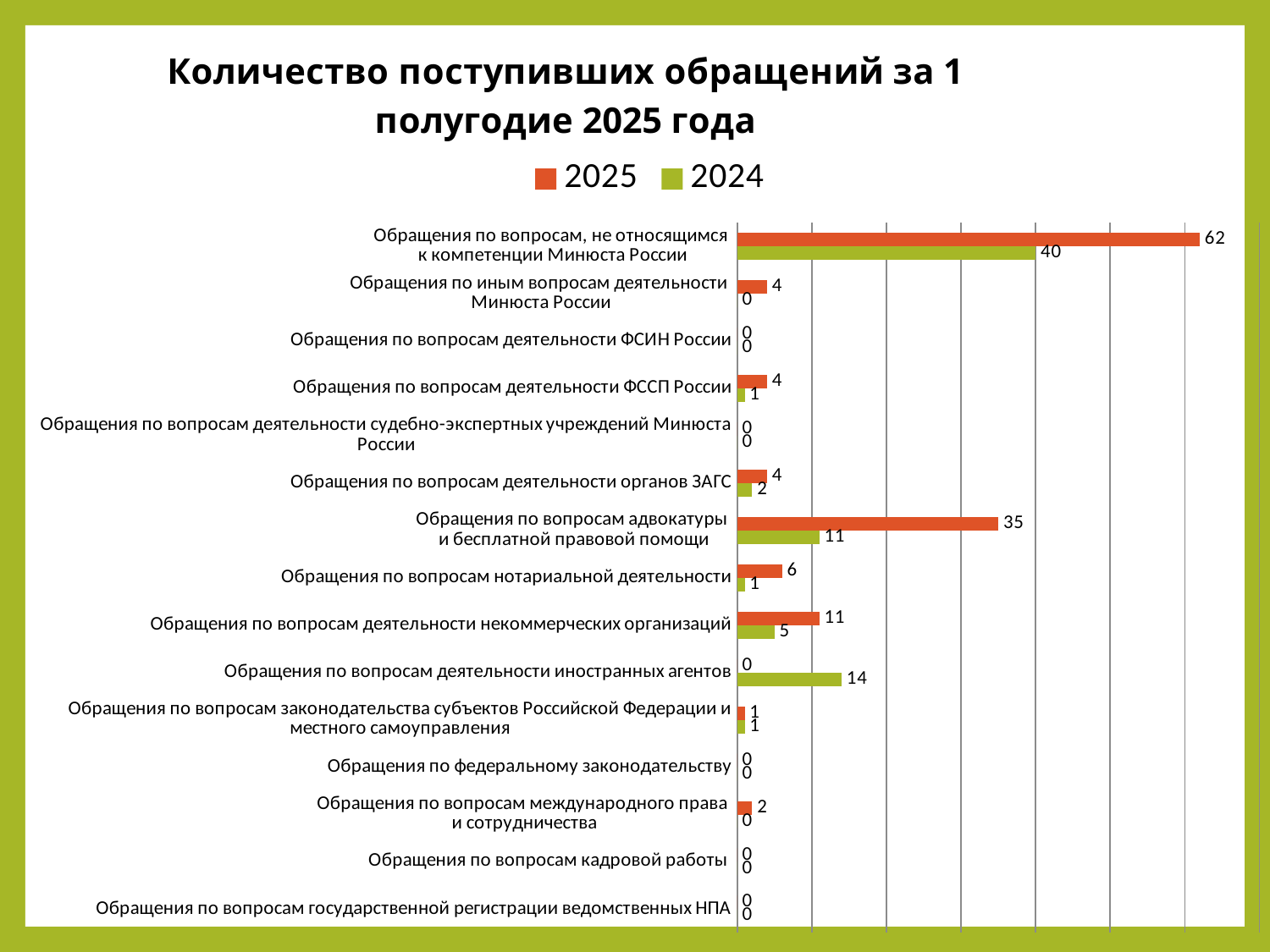
What is the 2025 value for «Обращения по вопросам адвокатуры и бесплатной правовой помощи»? 35 Which category has the highest 2025 value? Обращения по вопросам, не относящимся к компетенции Минюста России What is the 2024 value for «Обращения по вопросам деятельности иностранных агентов»? 14 For «Обращения по вопросам деятельности иностранных агентов», which year has the larger value, 2025 or 2024? 2024 How many categories are shown on the chart? 15 For «Обращения по вопросам нотариальной деятельности», which year has the larger value, 2025 or 2024? 2025 What is the difference between the 2025 and 2024 values for «Обращения по вопросам адвокатуры и бесплатной правовой помощи»? 24 What is the 2024 value for «Обращения по вопросам деятельности некоммерческих организаций»? 5 What type of chart is shown on the slide? Bar chart How many series does the legend list? 2 Which category has the highest 2024 value? Обращения по вопросам, не относящимся к компетенции Минюста России What is the difference between the 2025 and 2024 values for «Обращения по вопросам, не относящимся к компетенции Минюста России»? 22